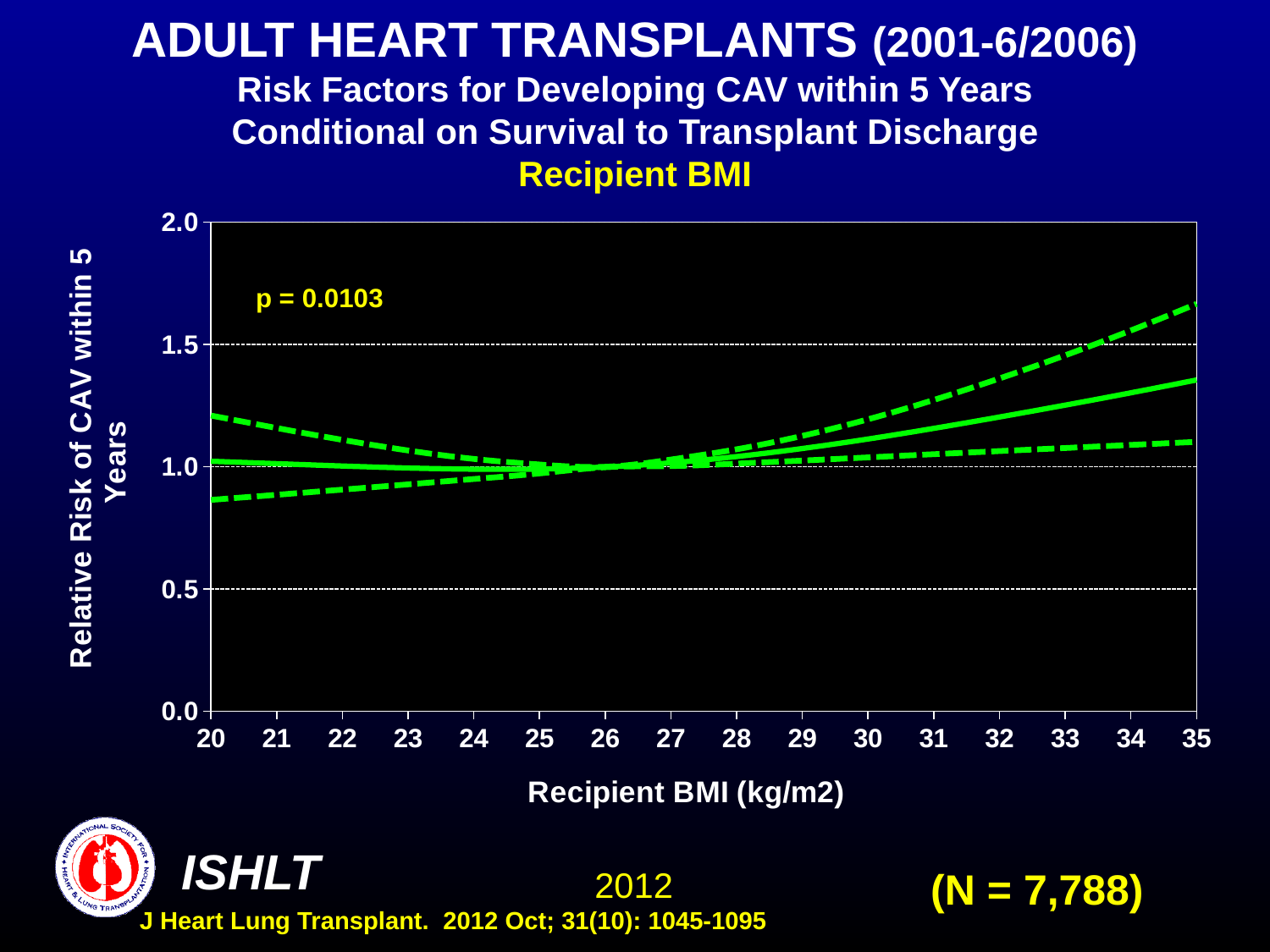
Is the value of the upper dashed line at a recipient BMI of 20 greater or less than 1.0? greater Does the solid line rise or fall as recipient BMI increases from 26 to 35? rise Is the value of the solid line at a recipient BMI of 35 greater or less than 1.5? less Is the value of the lower dashed line at a recipient BMI of 20 greater or less than 1.0? less What kind of chart is shown on the slide? line chart How many lines are plotted on the chart? 3 What is the p-value printed on the chart? p = 0.0103 What is the sample size (N) shown on the slide? N = 7,788 How many tick labels are shown on the x axis? 16